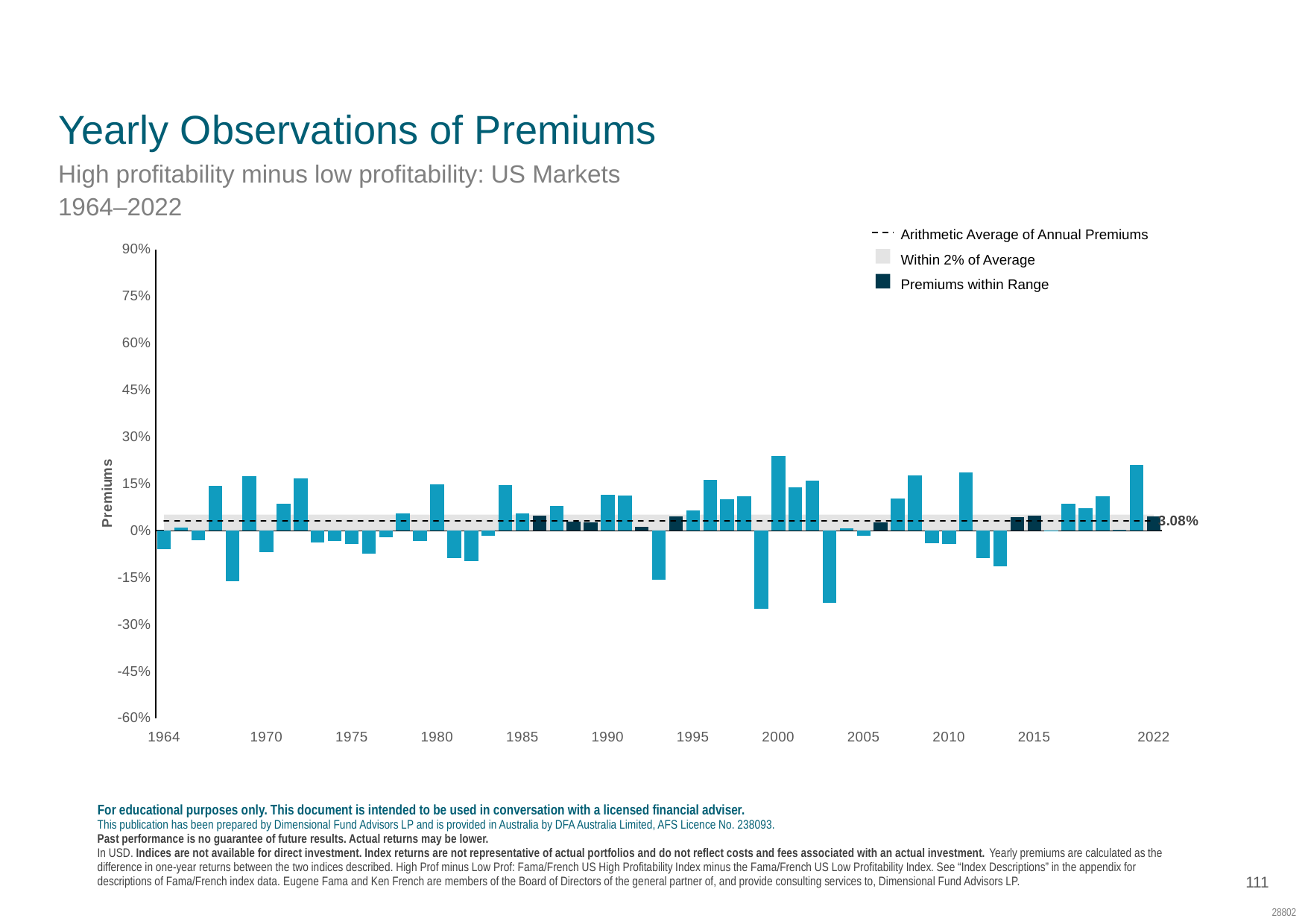
What is the title of the chart on the slide? Yearly Observations of Premiums Is the premium for 1999 greater or less than -15%? less What is the arithmetic average of annual premiums shown on the chart? 3.08% Which year has the larger premium, 2000 or 1995? 2000 How many entries does the chart's legend list? 3 Is the premium for 1990 greater or less than 0%? greater Is the premium for 1964 greater or less than 0%? less What is the label on the vertical axis of the chart? Premiums What kind of chart is shown on the slide? bar chart What is the last year shown on the horizontal axis of the chart? 2022